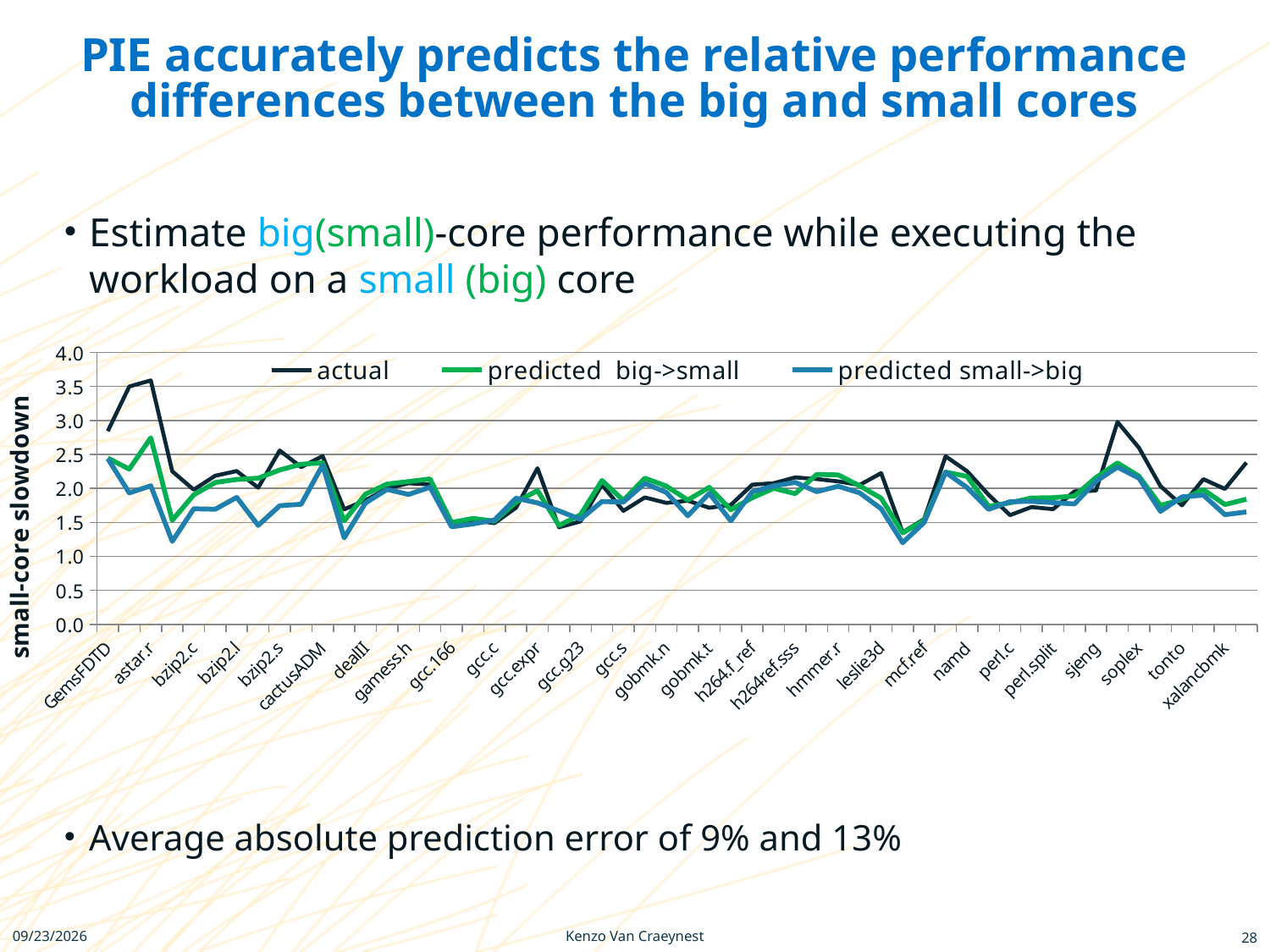
Is the value of the 'predicted big->small' series at astar.r greater or less than 2.5? greater Which series reaches the highest value anywhere on the chart? actual At astar.r, which series has the larger value: 'actual' or 'predicted small->big'? actual What is the label of the vertical axis of the chart? small-core slowdown What kind of chart is shown on the slide? line chart What are the three series named in the chart legend? actual, predicted big->small, predicted small->big Is the value of the 'actual' series at astar.r greater or less than 3.0? greater How many series does the chart legend list? 3 Is the value of the 'predicted small->big' series at bzip2.c greater or less than 1.5? greater